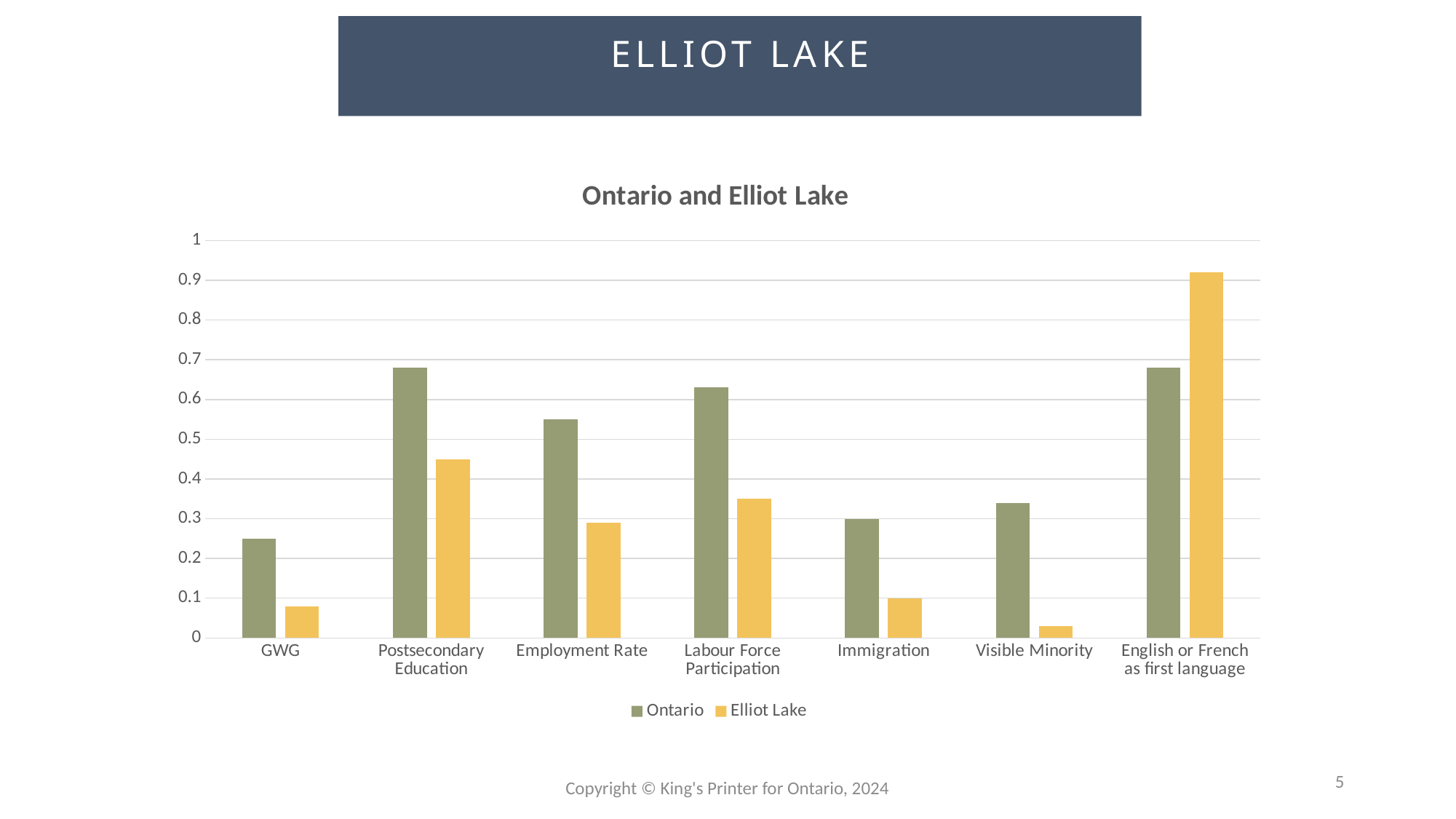
Is the Elliot Lake value for GWG greater or less than 0.1? less For Employment Rate, which is larger: the Ontario value or the Elliot Lake value? Ontario How many categories are shown on the x axis? 7 What kind of chart is shown on the slide? Bar chart How many series does the legend list? 2 Is the Ontario value for Labour Force Participation greater or less than 0.6? greater What is the title of the chart? Ontario and Elliot Lake For English or French as first language, which is larger: the Ontario value or the Elliot Lake value? Elliot Lake Which category has the lowest Elliot Lake value? Visible Minority Which category has the lowest Ontario value? GWG Which category has the highest Elliot Lake value? English or French as first language Is the Elliot Lake value for English or French as first language greater or less than 0.8? greater